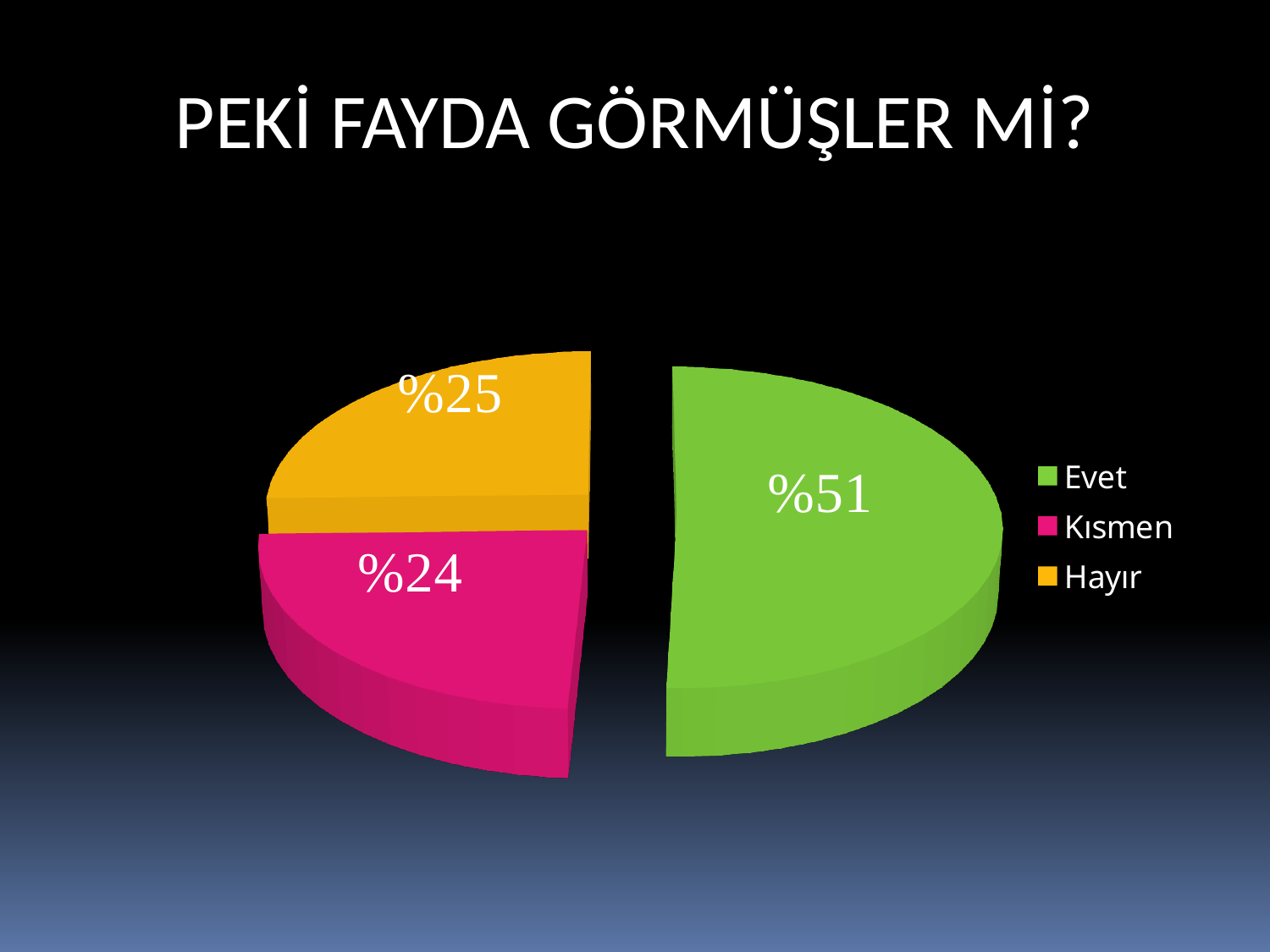
How many categories does the pie chart have? 3 Which colour represents Hayır in the legend? orange What kind of chart is shown on the slide? pie chart What is the difference between the values for Hayır and Kısmen? %1 Which is larger, the value for Evet or the value for Kısmen? Evet Which category has the largest share of the pie? Evet What is the title of the slide? PEKİ FAYDA GÖRMÜŞLER Mİ? What is the value for Evet? %51 What is the difference between the values for Evet and Hayır? %26 What is the value for Kısmen? %24 What is the value for Hayır? %25 Which category has the smallest share of the pie? Kısmen